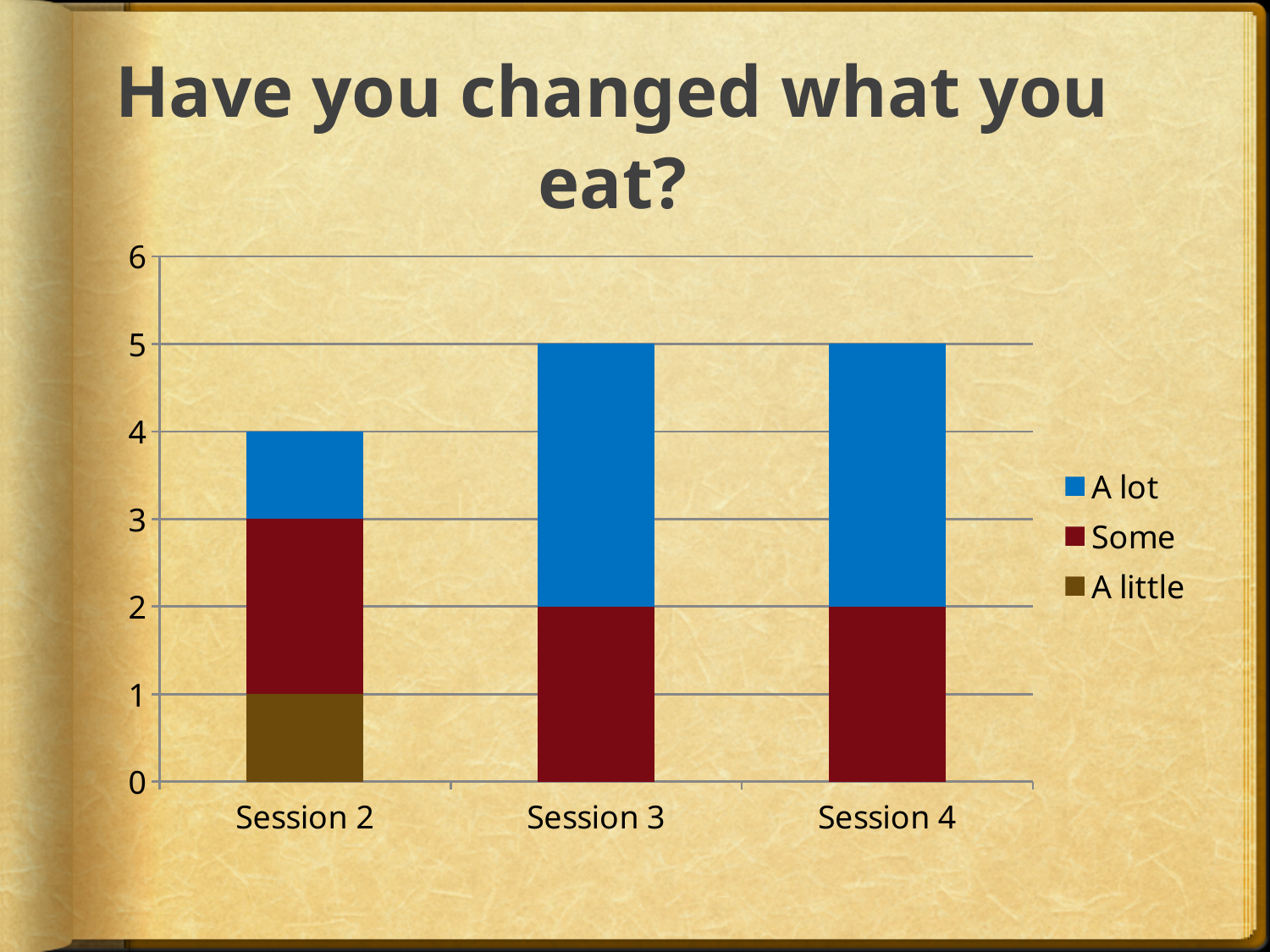
What is the total height of the stacked bar for Session 3? 5 Which session has a larger 'A lot' segment, Session 2 or Session 4? Session 4 What kind of chart is shown on the slide? Stacked bar chart How many sessions (categories) are shown on the x axis? 3 What is the title of the chart? Have you changed what you eat? What is the value of the 'Some' segment for Session 4? 2 Which session has the lowest total bar height? Session 2 How many series does the legend list? 3 What is the total height of the stacked bar for Session 2? 4 What is the value of the 'A little' segment for Session 2? 1 What is the value of the 'A lot' segment for Session 3? 3 What is the difference between the total for Session 3 and the total for Session 2? 1